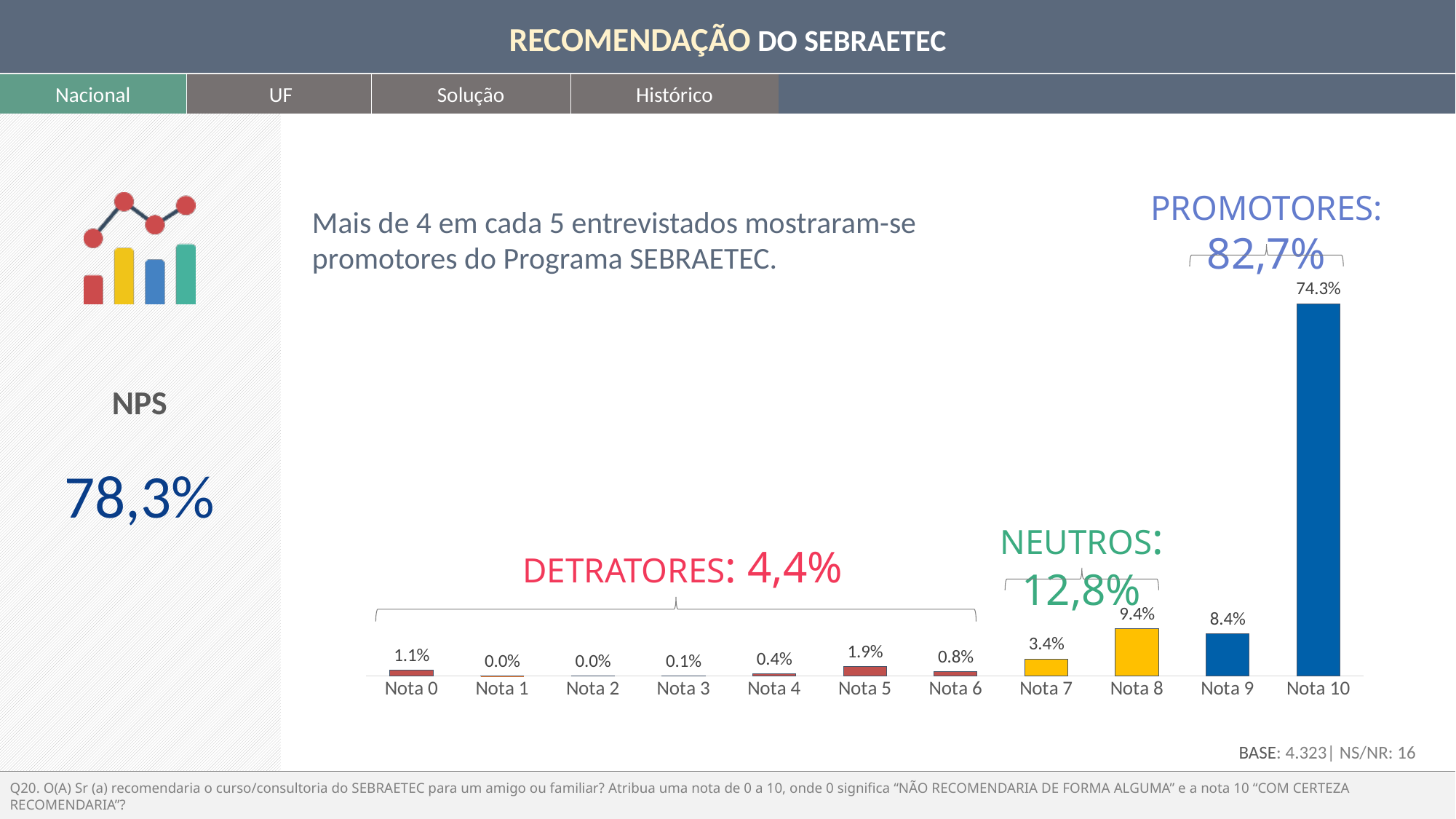
Which is larger, the value for Nota 7 or the value for Nota 9? Nota 9 What is the value for Nota 8? 9.4% How many categories (Nota bars) are shown in the chart? 11 Which category has the highest value? Nota 10 What is the value for Nota 5? 1.9% What is the value for Nota 10? 74.3% What is the difference between the values for Nota 10 and Nota 8? 64.9% What percentage is shown for the PROMOTORES group? 82,7% What is the difference between the values for Nota 8 and Nota 9? 1.0% Which is larger, the value for Nota 0 or the value for Nota 5? Nota 5 What kind of chart is shown on the slide? bar chart What percentage is shown for the DETRATORES group? 4,4%